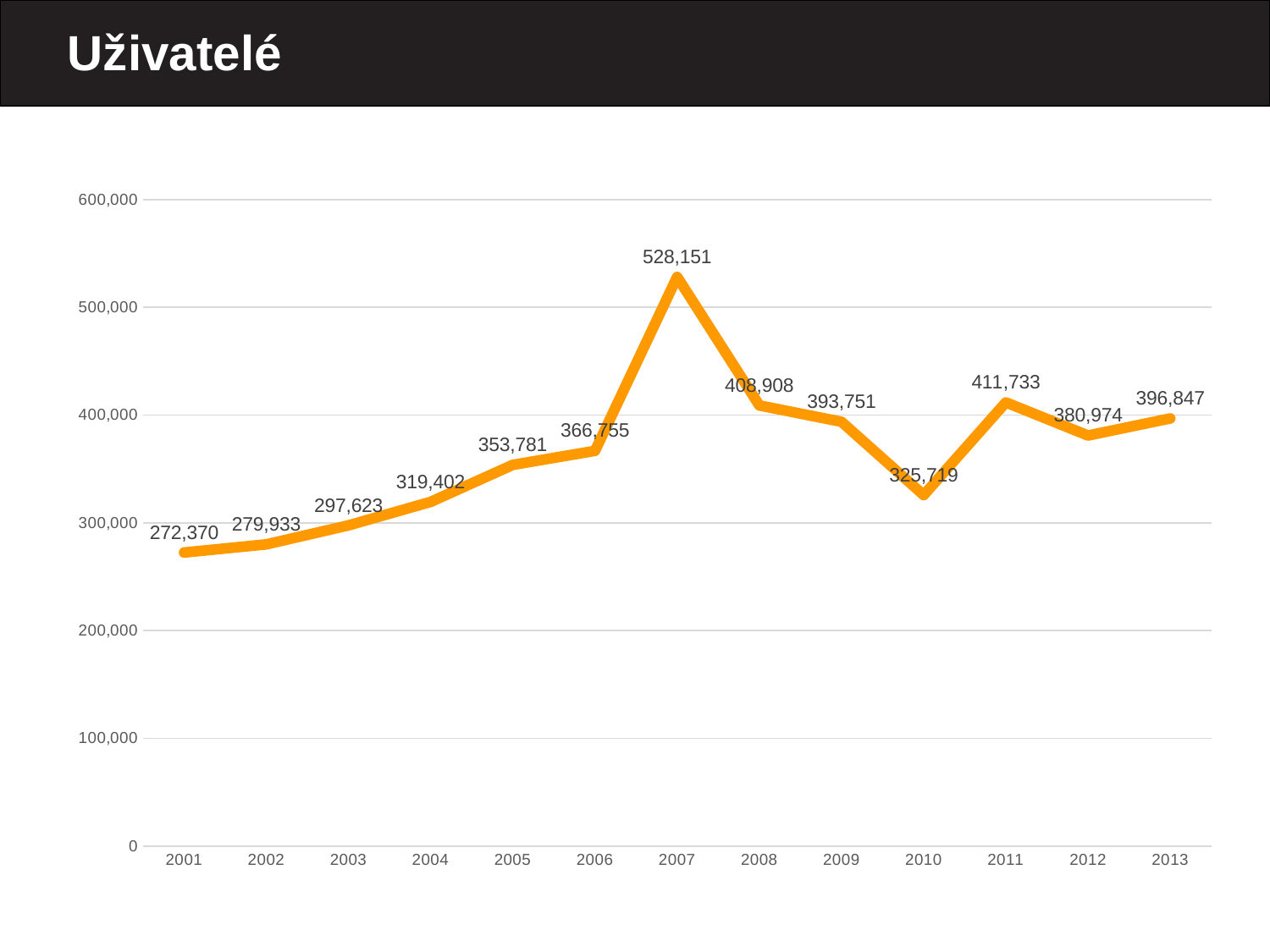
Is the value for 2010 greater or less than 400,000? less What kind of chart is shown on the slide? line chart Which year has the lowest value? 2001 What is the value for 2013? 396,847 How many years are plotted on the x axis? 13 What is the value for 2001? 272,370 Which is larger, the value for 2011 or the value for 2009? 2011 What is the difference between the values for 2007 and 2008? 119,243 What is the title of the slide? Uživatelé Which year has the highest value? 2007 Do the values rise or fall from 2001 to 2007? rise What is the value for 2007? 528,151